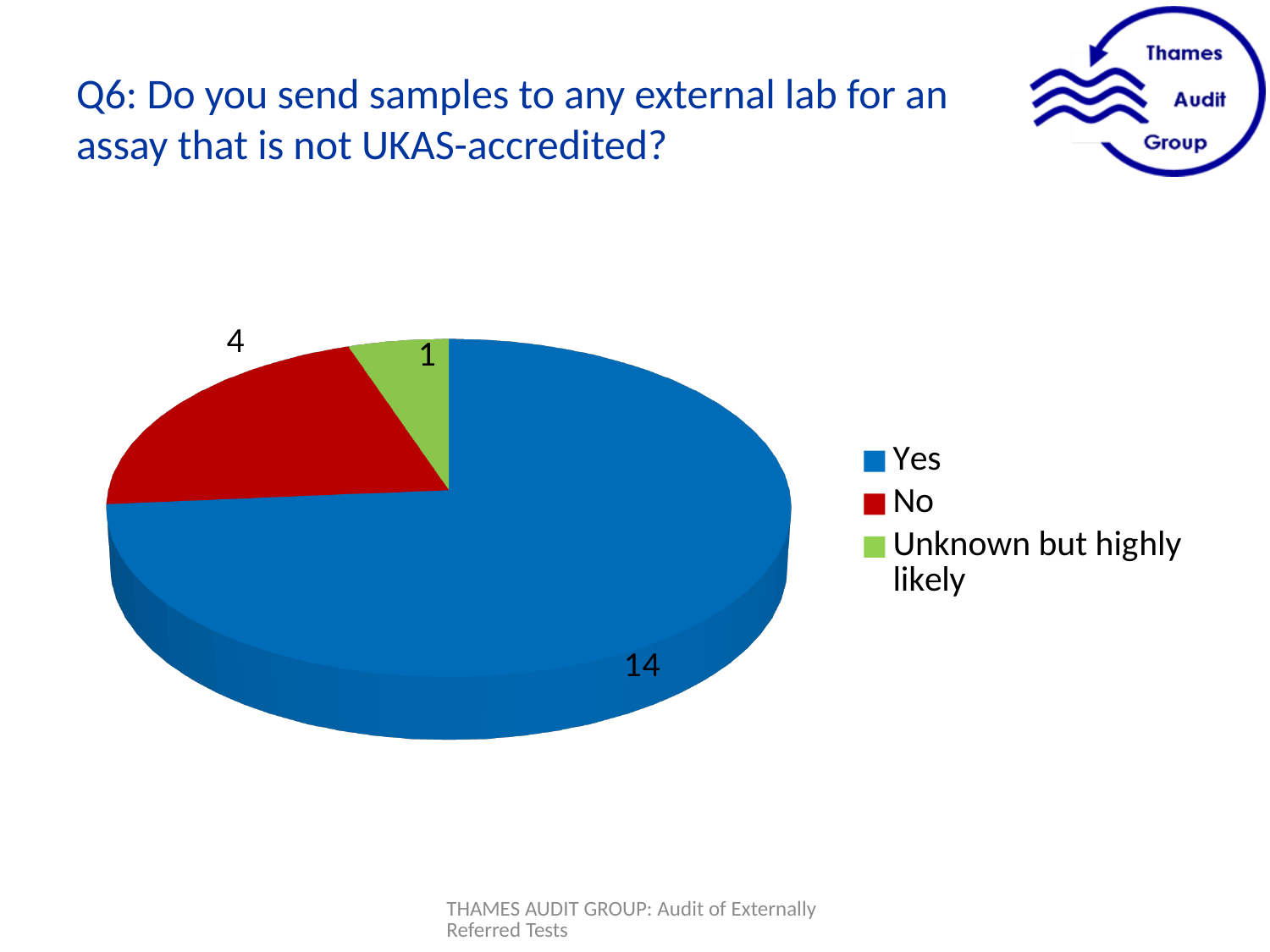
What colour is the No slice? Red Which category has the largest slice? Yes What is the total of all slices in the pie chart? 19 What is the value for No? 4 Which is larger, the value for No or the value for Unknown but highly likely? No Which category has the smallest slice? Unknown but highly likely What colour is the Yes slice? Blue How many categories does the pie chart show? 3 What is the value for Yes? 14 What is the value for Unknown but highly likely? 1 What kind of chart is shown on the slide? Pie chart What is the difference between the values for Yes and No? 10